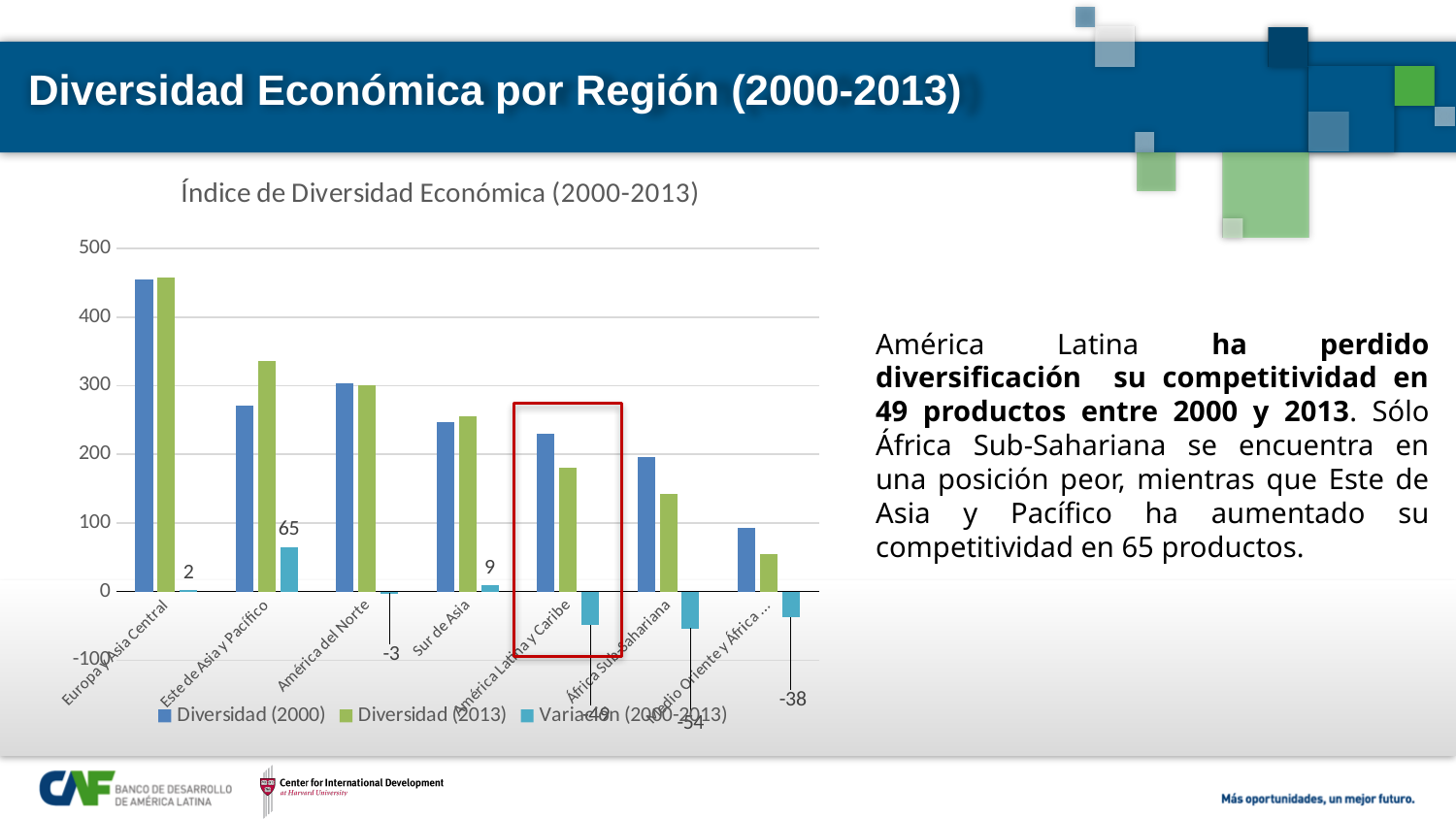
What is the title of the chart? Índice de Diversidad Económica (2000-2013) What is the Variación (2000-2013) value for Sur de Asia? 9 How many series does the legend list? 3 What is the Variación (2000-2013) value for Este de Asia y Pacífico? 65 What type of chart is shown on the slide? bar chart For América Latina y Caribe, which is larger: Diversidad (2000) or Diversidad (2013)? Diversidad (2000) Which region has the lowest Variación (2000-2013)? África Subsahariana Is the Diversidad (2000) value for Europa y Asia Central greater or less than 400? greater How many regions are shown on the x axis? 7 Which region has the highest Variación (2000-2013)? Este de Asia y Pacífico What is the Variación (2000-2013) value for África Subsahariana? -54 What is the difference between the Variación (2000-2013) values for Este de Asia y Pacífico and Sur de Asia? 56